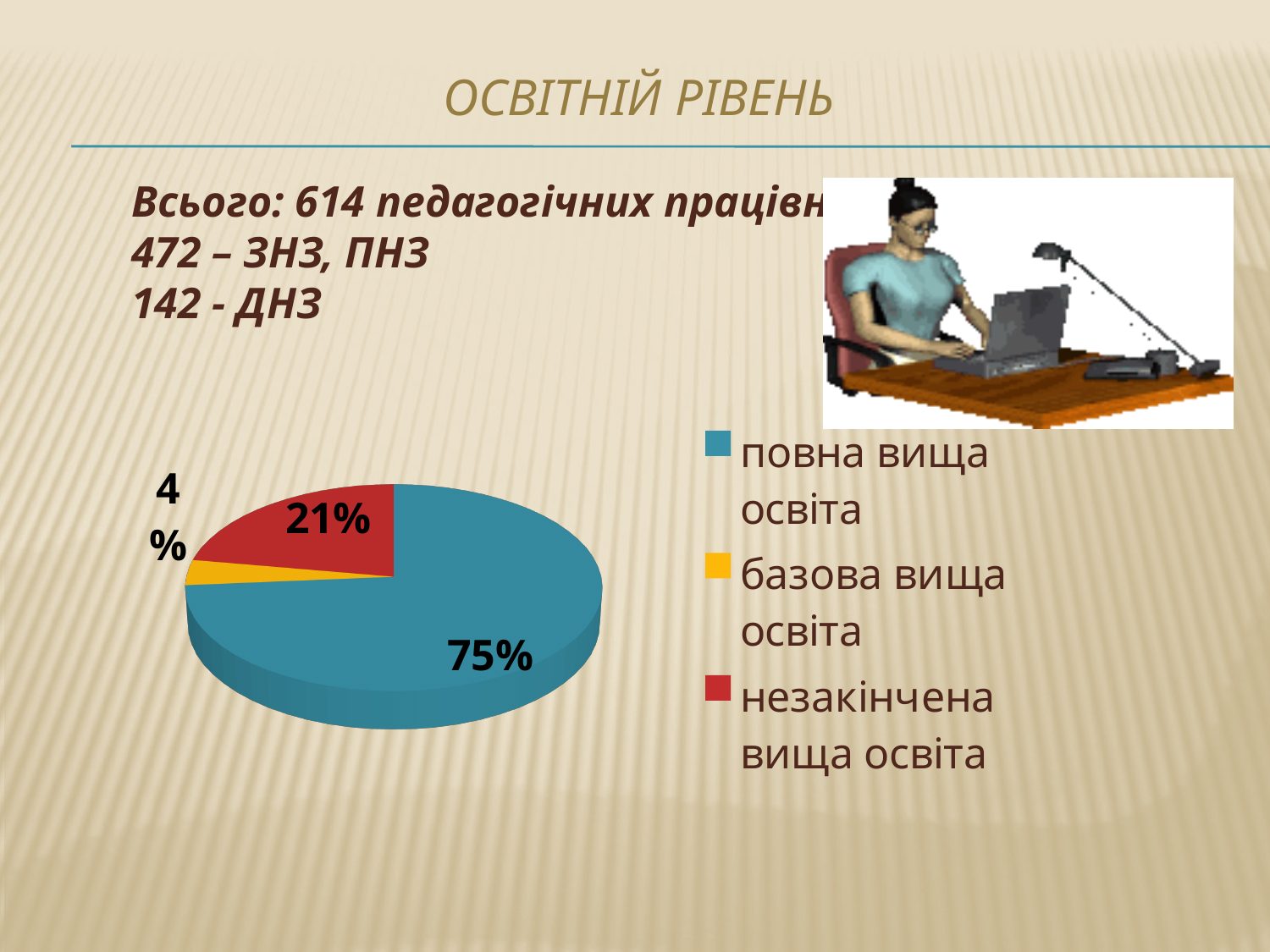
How many entries does the legend list? 3 What kind of chart is shown on the slide? pie chart What share of the pie does "незакінчена вища освіта" have? 21% What is the difference in percentage points between "повна вища освіта" and "незакінчена вища освіта"? 54 Which category has the largest slice of the pie? повна вища освіта Which is larger: the slice for "незакінчена вища освіта" or the slice for "базова вища освіта"? незакінчена вища освіта What colour is the slice for "незакінчена вища освіта"? red What share of the pie does "базова вища освіта" have? 4% What share of the pie does "повна вища освіта" have? 75% What is the title of the slide containing the pie chart? ОСВІТНІЙ РІВЕНЬ Which category has the smallest slice of the pie? базова вища освіта How many slices does the pie chart have? 3